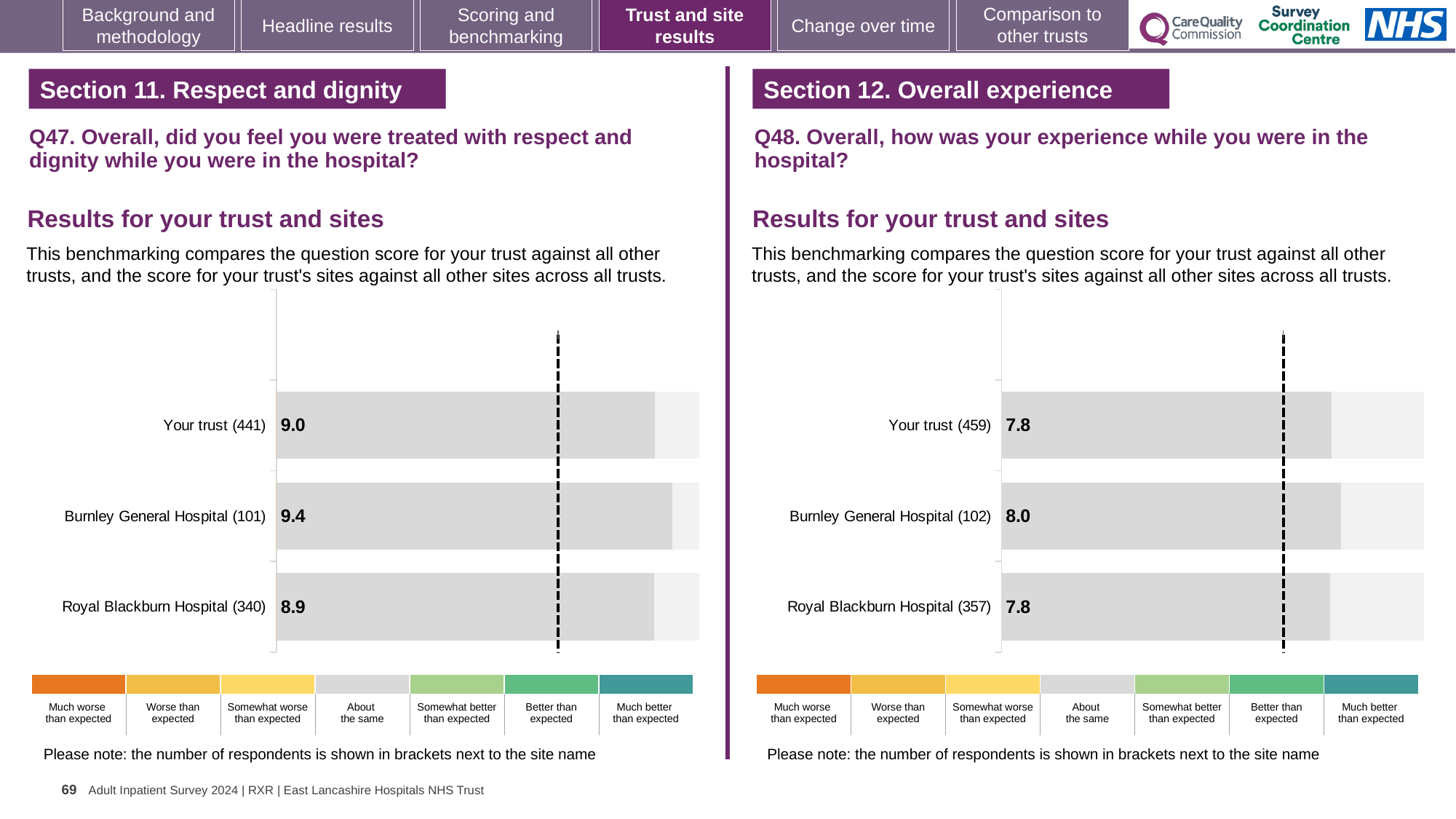
In the Q48 chart on the right, which site or trust has the highest score? Burnley General Hospital In the Q47 chart on the left, what is the score for Your trust? 9.0 In the Q47 chart on the left, which site or trust has the highest score? Burnley General Hospital In the Q47 chart on the left, what is the difference between the scores for Burnley General Hospital and Royal Blackburn Hospital? 0.5 What kind of chart is used in the Q48 chart on the right? Bar chart In the Q47 chart on the left, what is the score for Burnley General Hospital? 9.4 How many bars are plotted in the Q47 chart on the left? 3 In the Q47 chart on the left, what is the score for Royal Blackburn Hospital? 8.9 In the Q48 chart on the right, how many respondents are shown in brackets for Your trust? 459 In the Q48 chart on the right, what is the score for Burnley General Hospital? 8.0 In the Q48 chart on the right, what is the score for Royal Blackburn Hospital? 7.8 In the Q47 chart on the left, which site or trust has the lowest score? Royal Blackburn Hospital